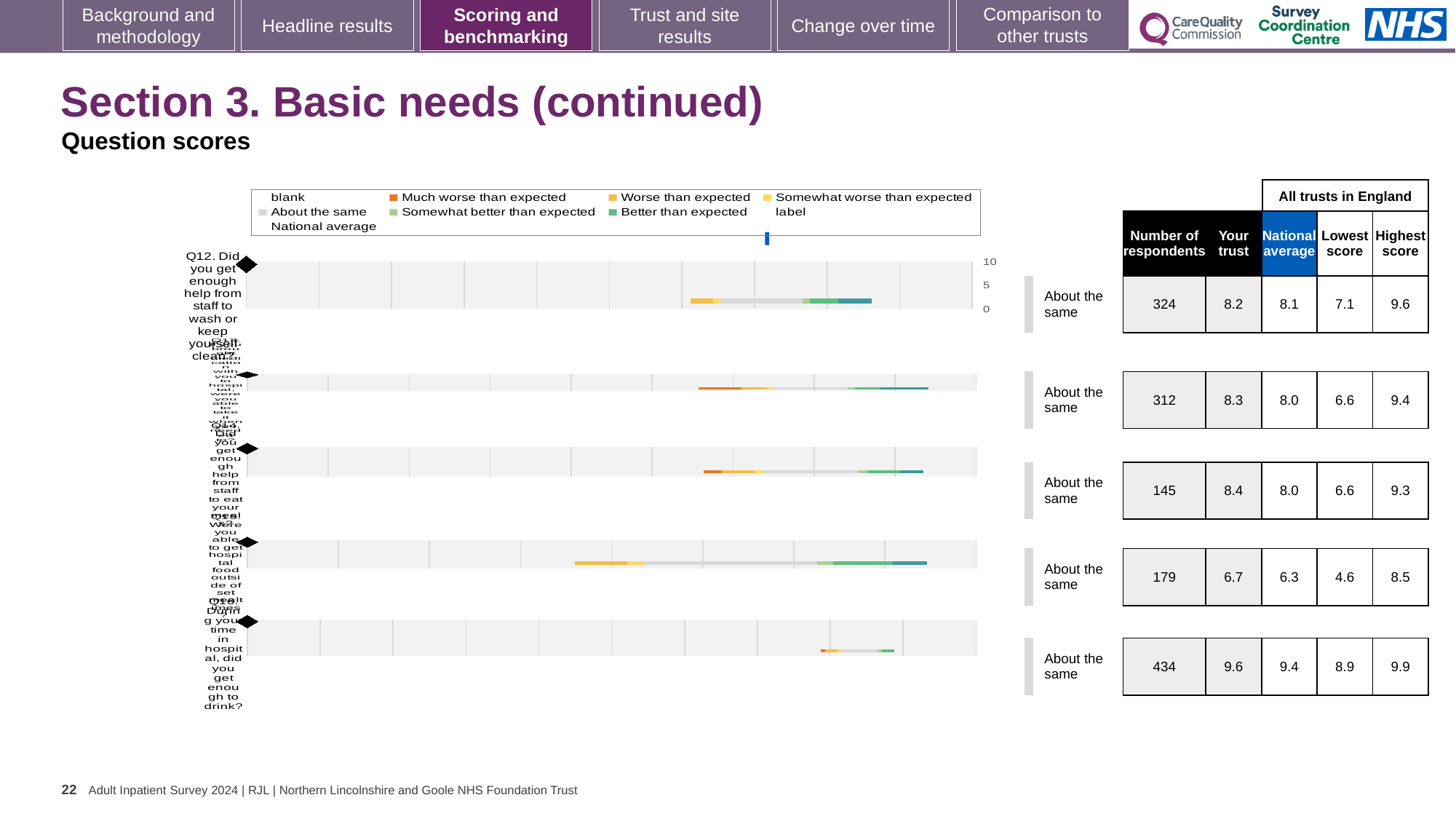
What is the highest 'Your trust' score listed in the table beside the chart? 9.6 In the table beside the chart, how many respondents are listed for the top row (Q12)? 324 How many question bars are plotted in the chart? 5 For the top row (Q12), what is the difference between the 'Your trust' score and the national average? 0.1 What is the lowest 'Your trust' score listed in the table beside the chart? 6.7 Which question is plotted in the top bar of the chart? Q12. Did you get enough help from staff to wash or keep yourself clean? What benchmark category is shown beside every bar in the chart? About the same In the table beside the chart, what is the 'Your trust' score for the top row (Q12)? 8.2 In the table beside the chart, what is the national average for the top row (Q12)? 8.1 For the bottom row of the table, is the 'Your trust' score higher or lower than the national average? higher In the legend, which colour represents 'Much worse than expected'? orange What kind of chart is used to show the question scores? bar chart